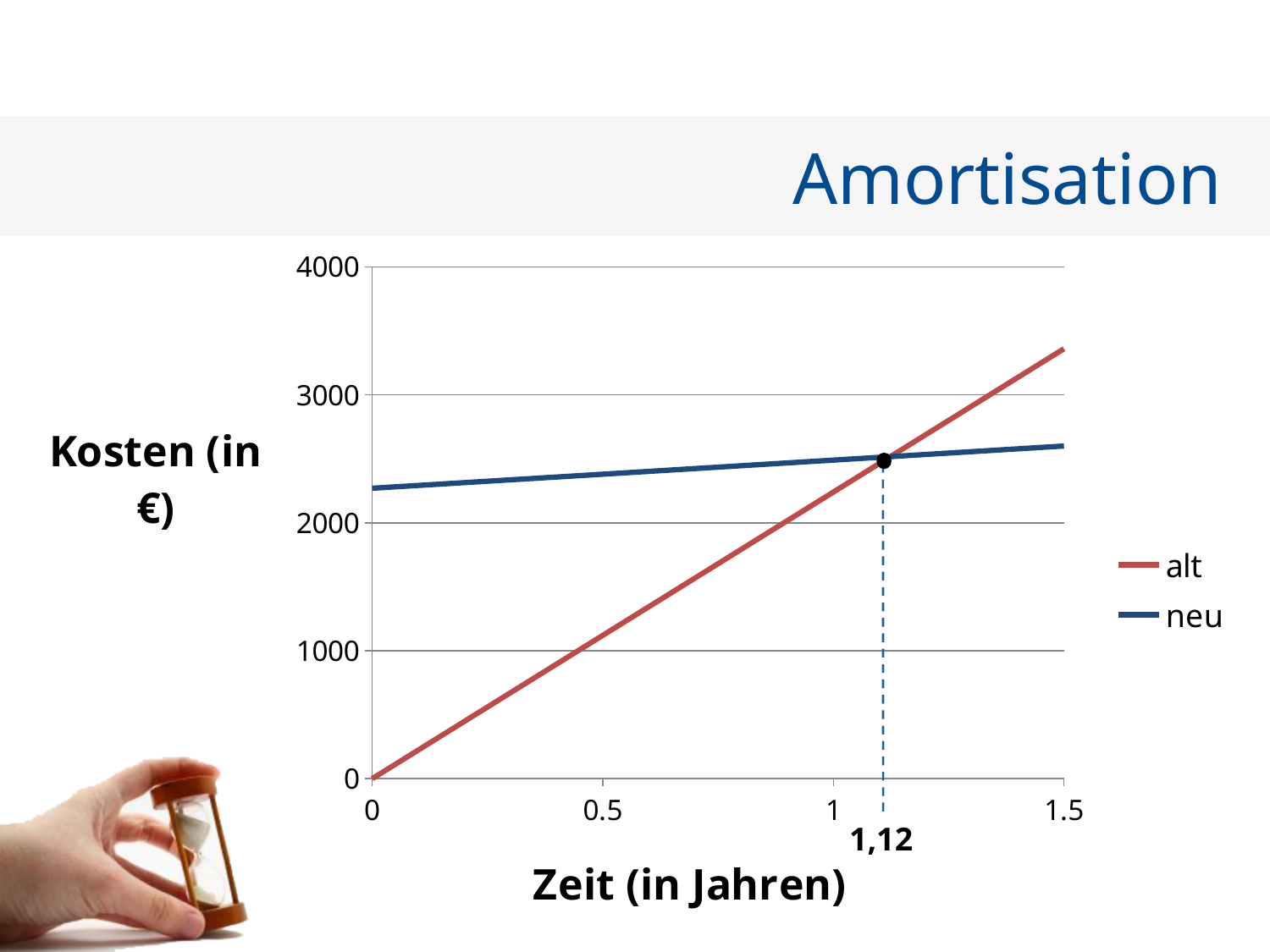
Does the 'alt' line rise or fall as time increases? rise Is the value of the 'alt' line at time 1.5 greater or less than 3000? greater Is the value of the 'neu' line at time 0 greater or less than 2000? greater At time 1.5, which series has the higher cost, 'alt' or 'neu'? alt What kind of chart is shown on the slide? line chart What is the value of the 'alt' line at time 0? 0 How many series does the legend list? 2 What are the two series named in the legend? alt and neu Does the 'neu' line rise or fall as time increases? rise At what time (in years) do the 'alt' and 'neu' lines intersect, as labelled on the chart? 1,12 What is the title of the slide above the chart? Amortisation At time 0, which series has the higher cost, 'alt' or 'neu'? neu